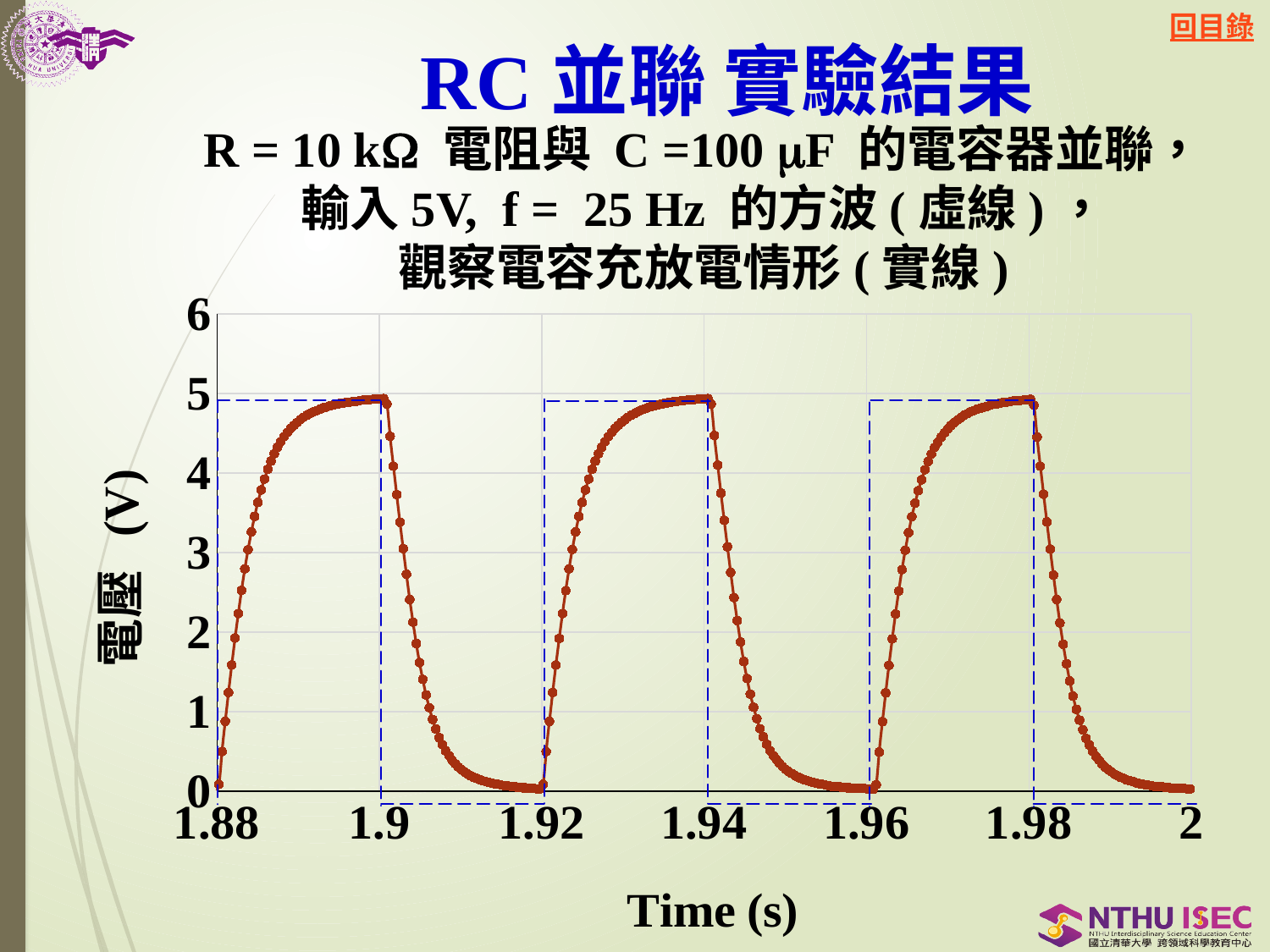
What is the highest value shown on the y axis? 6 What kind of chart is shown on the slide? line chart What is the low level of the dashed square wave, in volts? 0 How many complete charge-and-discharge cycles of the solid line are shown between 1.88 s and 2 s? 3 What is the high level of the dashed square wave, in volts? 5 How many tick labels are shown on the x axis? 7 Is the value of the solid line at 1.89 s greater or less than 3? greater What is the label of the x axis? Time (s) Does the solid line rise or fall between 1.88 s and 1.9 s? rise Does the solid line rise or fall between 1.9 s and 1.92 s? fall What is the label of the y axis? 電壓 (V) Is the value of the solid line at 1.91 s greater or less than 3? less